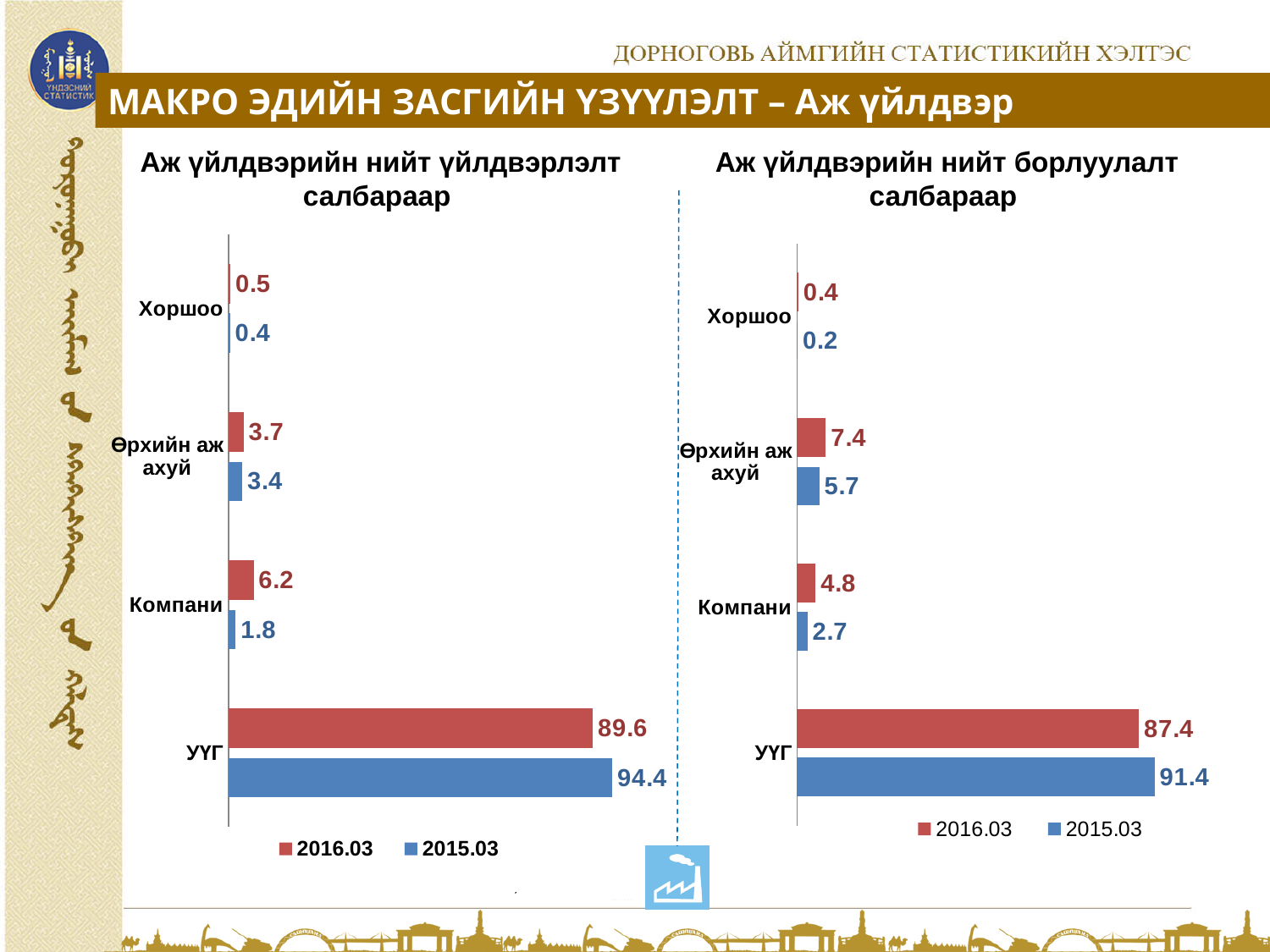
In the left chart (Аж үйлдвэрийн нийт үйлдвэрлэлт салбараар), what is the difference between the 2015.03 and 2016.03 values for УҮГ? 4.8 In the right chart (Аж үйлдвэрийн нийт борлуулалт салбараар), which category has the lowest 2016.03 value? Хоршоо How many categories are shown in the right chart (Аж үйлдвэрийн нийт борлуулалт салбараар)? 4 In the right chart (Аж үйлдвэрийн нийт борлуулалт салбараар), what is the 2016.03 value for Өрхийн аж ахуй? 7.4 In the left chart (Аж үйлдвэрийн нийт үйлдвэрлэлт салбараар), what is the 2016.03 value for УҮГ? 89.6 In the left chart (Аж үйлдвэрийн нийт үйлдвэрлэлт салбараар), what is the 2015.03 value for Компани? 1.8 What type of chart is the right chart (Аж үйлдвэрийн нийт борлуулалт салбараар)? Bar chart In the left chart (Аж үйлдвэрийн нийт үйлдвэрлэлт салбараар), which category has the highest 2015.03 value? УҮГ In the left chart (Аж үйлдвэрийн нийт үйлдвэрлэлт салбараар), which is larger for Компани: the 2016.03 value or the 2015.03 value? 2016.03 In the right chart (Аж үйлдвэрийн нийт борлуулалт салбараар), what is the difference between the 2016.03 and 2015.03 values for Компани? 2.1 How many series does the legend of the left chart (Аж үйлдвэрийн нийт үйлдвэрлэлт салбараар) list? 2 In the right chart (Аж үйлдвэрийн нийт борлуулалт салбараар), what is the 2015.03 value for УҮГ? 91.4